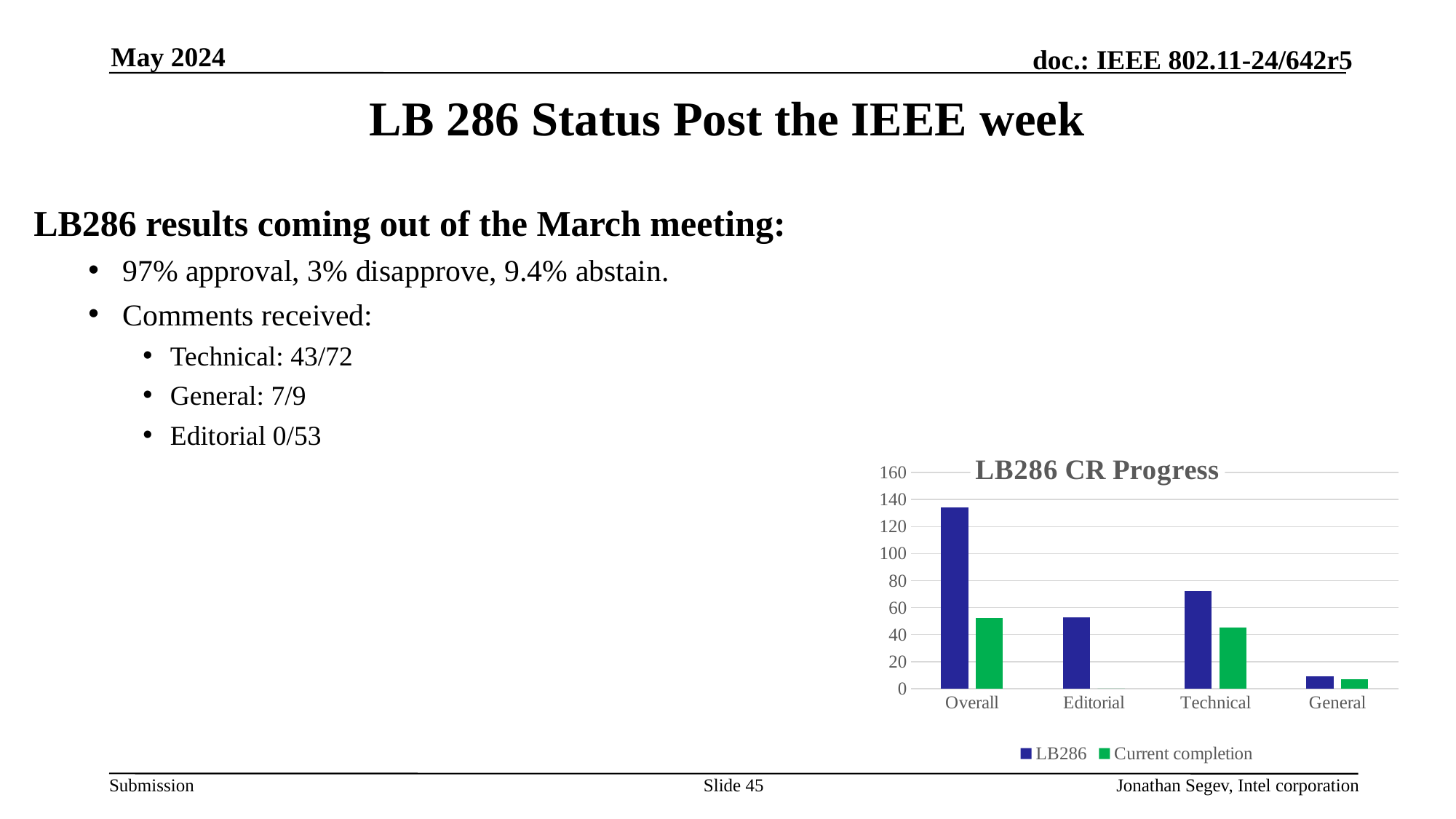
In the LB286 CR Progress chart, which is larger for Technical: the LB286 value or the Current completion value? LB286 In the LB286 CR Progress chart, which category has the higher Current completion value: Overall or Technical? Overall Which category has the highest LB286 value in the LB286 CR Progress chart? Overall How many series does the legend of the LB286 CR Progress chart list? 2 Is the Current completion value for Technical greater or less than 60 in the LB286 CR Progress chart? less Is the LB286 value for General greater or less than 20 in the LB286 CR Progress chart? less Which category has the lowest LB286 value in the LB286 CR Progress chart? General What is the title of the chart on the slide? LB286 CR Progress Is the LB286 value for Technical greater or less than 60 in the LB286 CR Progress chart? greater What type of chart is the LB286 CR Progress chart? bar chart How many categories are shown on the x axis of the LB286 CR Progress chart? 4